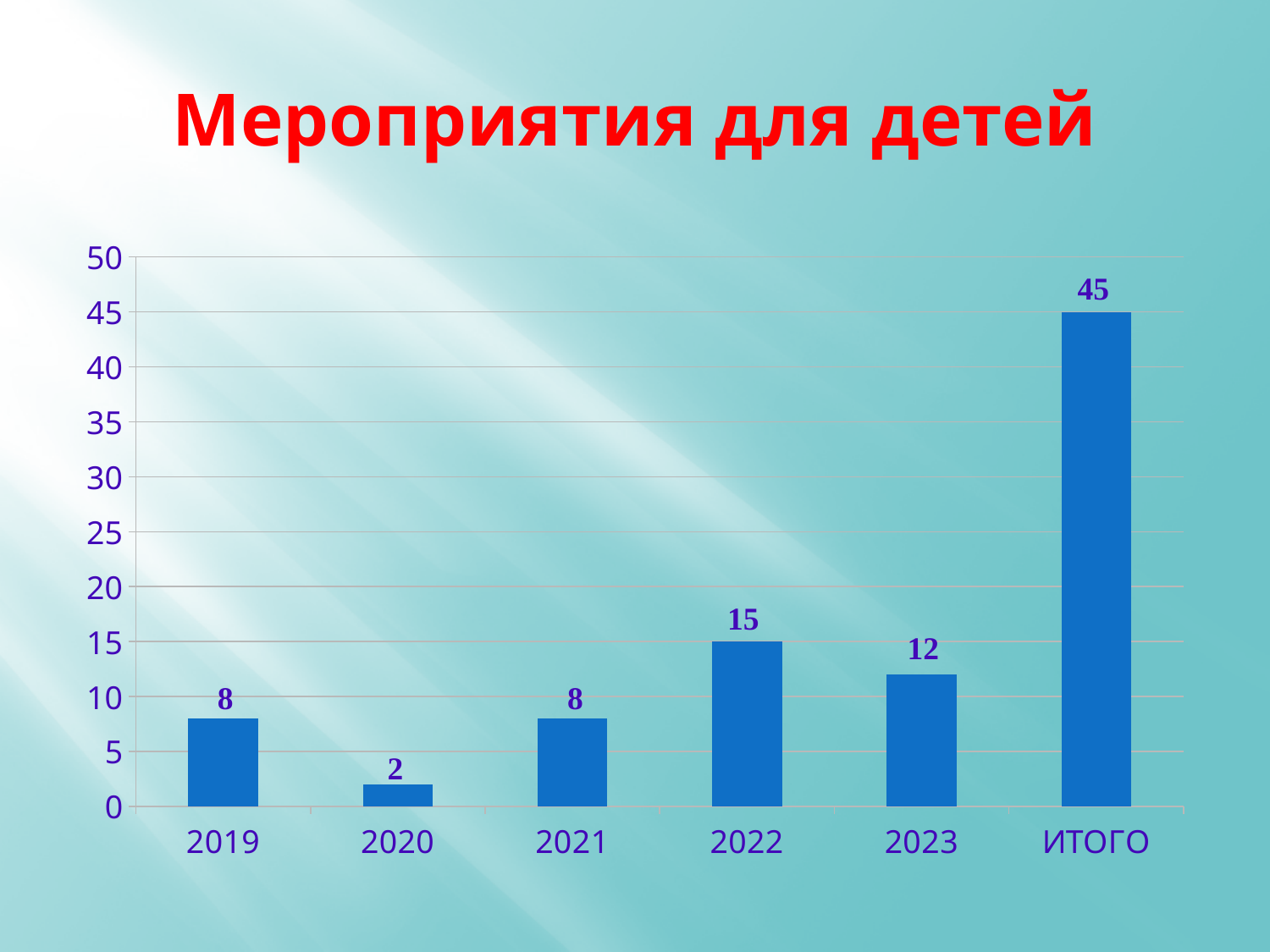
What kind of chart is shown on the slide? Bar chart Which year from 2019 to 2023 has the highest value? 2022 What is the value for 2020? 2 What is the value for 2022? 15 Which is larger, the value for 2021 or the value for 2023? 2023 Which category has the lowest value? 2020 What is the value for ИТОГО? 45 What is the value for 2019? 8 What is the difference between the values for 2022 and 2023? 3 What is the value for 2023? 12 How many categories are shown on the x axis? 6 What is the title of the slide? Мероприятия для детей